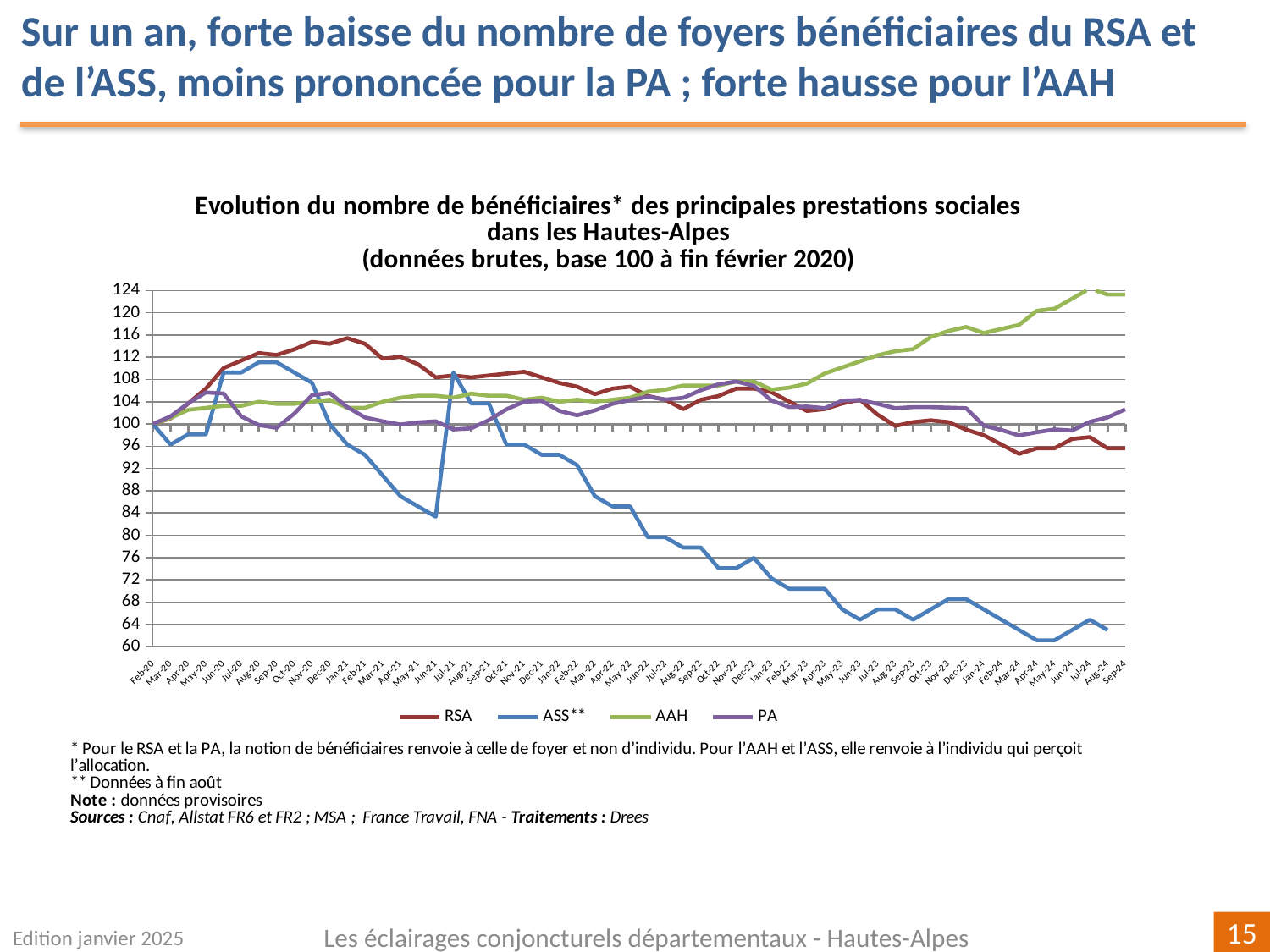
What kind of chart is shown on the slide? line chart Does the ASS** series rise or fall overall from Feb-20 to Sep-24? fall At Sep-24, which is larger: the value for RSA or the value for PA? PA Which series has the highest value at Sep-24? AAH Which series are listed in the legend? RSA, ASS**, AAH, PA How many series does the legend list? 4 Is the value for AAH at Sep-24 greater or less than 120? greater Is the value for RSA at Sep-24 greater or less than 100? less According to the chart title, what is the base period for the index of 100? fin février 2020 Does the AAH series rise or fall overall from Feb-20 to Sep-24? rise Which series has the lowest value at Sep-24? RSA